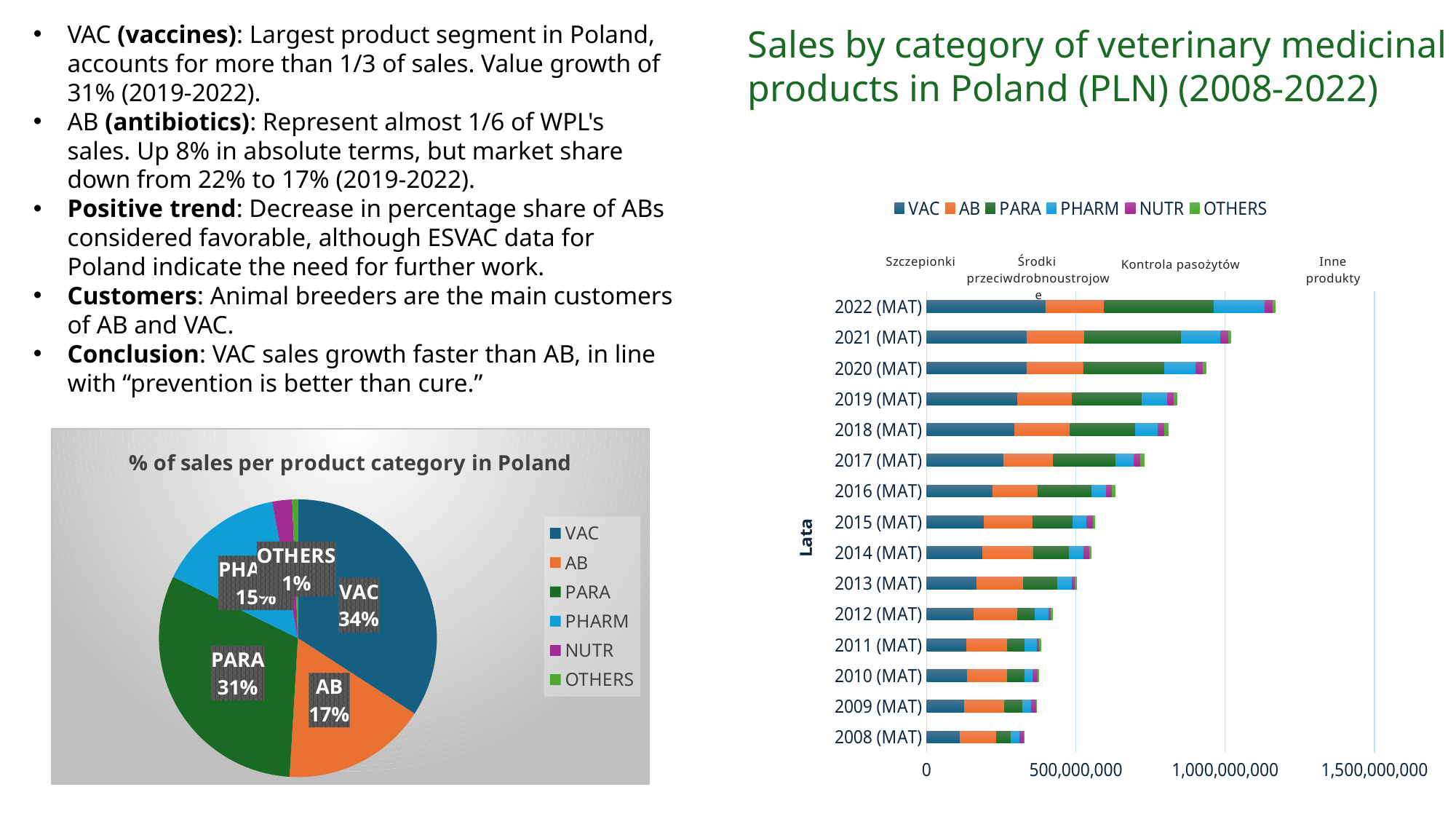
In the pie chart '% of sales per product category in Poland', what share does PARA have? 31% In the pie chart '% of sales per product category in Poland', what share does AB have? 17% How many entries does the legend of the pie chart '% of sales per product category in Poland' list? 6 In the pie chart '% of sales per product category in Poland', what share does VAC have? 34% In the chart 'Sales by category of veterinary medicinal products in Poland (PLN) (2008-2022)', is the total for 2022 (MAT) greater or less than 1,000,000,000? greater In the pie chart '% of sales per product category in Poland', what is the difference in percentage points between VAC and AB? 17 In the chart 'Sales by category of veterinary medicinal products in Poland (PLN) (2008-2022)', how many years are shown? 15 In the pie chart '% of sales per product category in Poland', which category has the largest share? VAC In the pie chart '% of sales per product category in Poland', which is larger, PARA or AB? PARA What kind of chart is 'Sales by category of veterinary medicinal products in Poland (PLN) (2008-2022)'? Stacked bar chart In the chart 'Sales by category of veterinary medicinal products in Poland (PLN) (2008-2022)', do total sales rise or fall from 2008 to 2022? rise In the chart 'Sales by category of veterinary medicinal products in Poland (PLN) (2008-2022)', is the total for 2008 (MAT) greater or less than 500,000,000? less